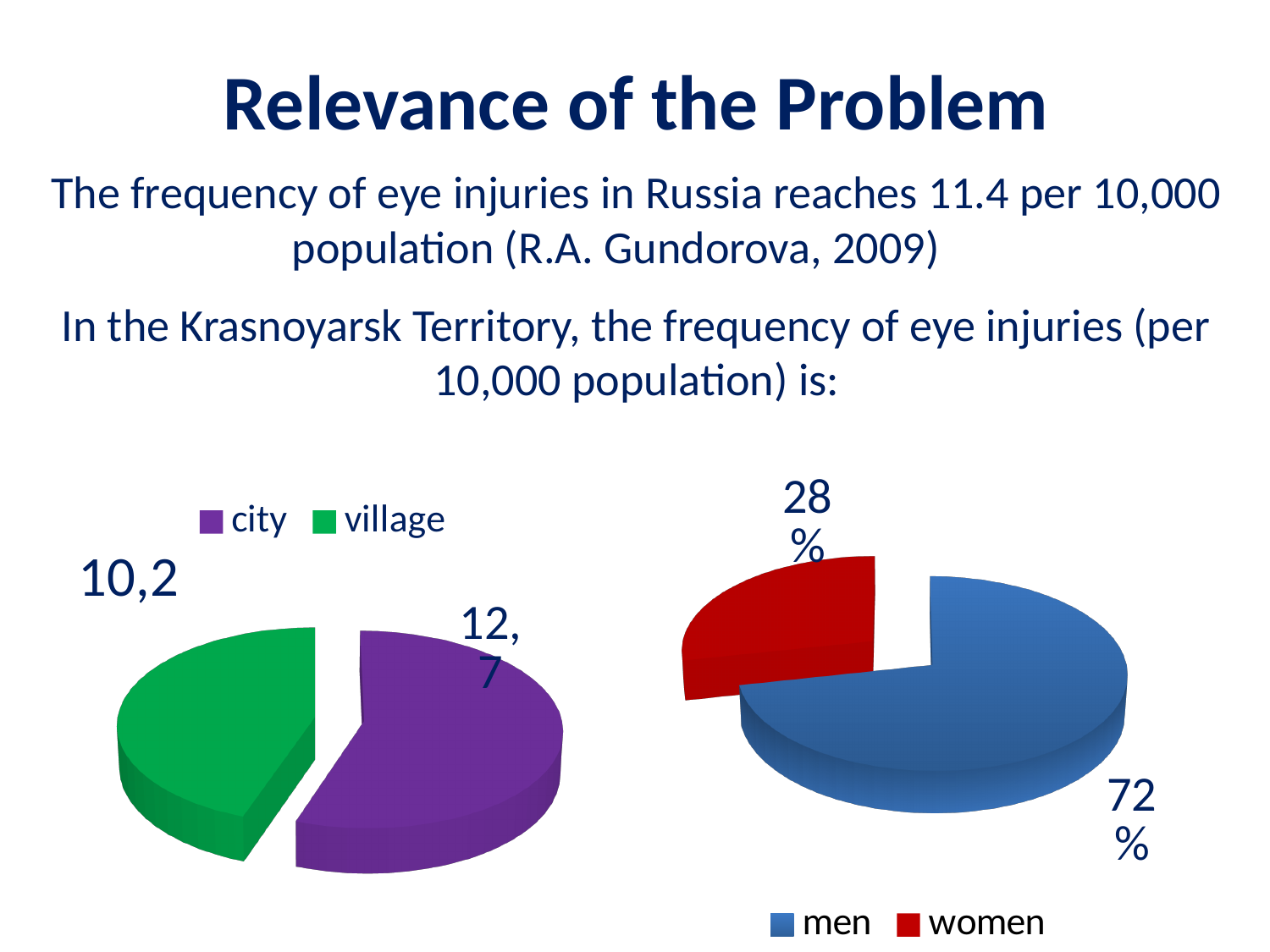
In the right pie chart, which group has the larger share? men In the right pie chart, what share is labelled for women? 28% In the right pie chart, what share is labelled for men? 72% In the left pie chart, what is the value for city? 12,7 In the right pie chart, which group has the smaller share? women In the left pie chart, what is the value for village? 10,2 In the left pie chart, which category has the higher value, city or village? city In the right pie chart, what colour is the slice for women? red In the left pie chart, how many slices are there? 2 What type of chart is the right chart? pie chart In the left pie chart, what is the difference between the city and village values? 2,5 In the right pie chart, by how many percentage points does the men's share exceed the women's share? 44 percentage points